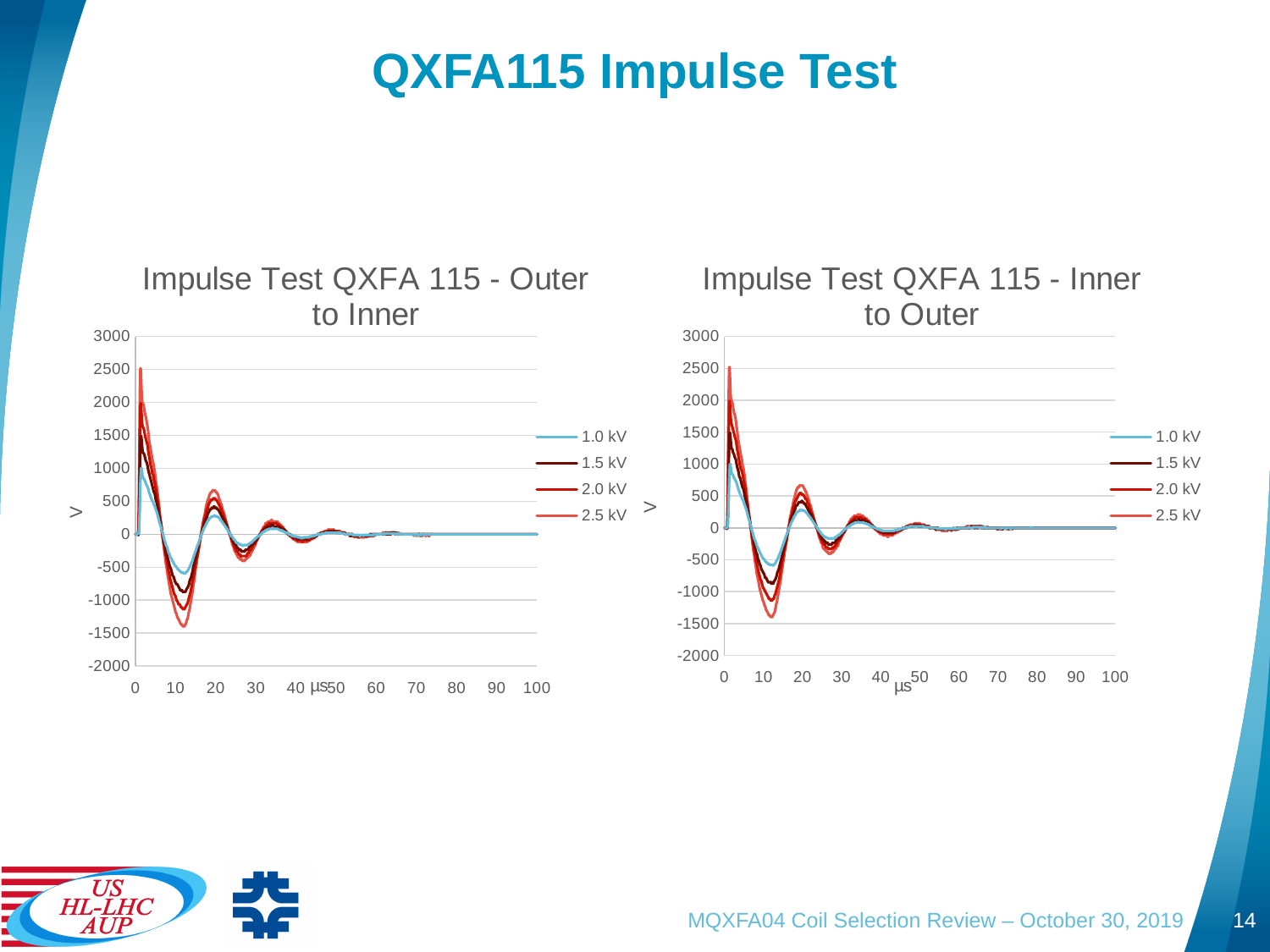
In the 'Impulse Test QXFA 115 - Outer to Inner' chart, which series has the larger first peak, 1.5 kV or 2.0 kV? 2.0 kV In the 'Impulse Test QXFA 115 - Outer to Inner' chart, is the peak value of the 2.5 kV series greater or less than 2000? greater In the 'Impulse Test QXFA 115 - Outer to Inner' chart, which series reaches the highest peak value? 2.5 kV In the 'Impulse Test QXFA 115 - Outer to Inner' chart, is the lowest value of the 2.5 kV series greater or less than -1000? less In the 'Impulse Test QXFA 115 - Inner to Outer' chart, how does the amplitude of the oscillation change as time increases along the x axis? It decreases toward 0 What is the x-axis unit label on the 'Impulse Test QXFA 115 - Inner to Outer' chart? µs How many series does the legend of the 'Impulse Test QXFA 115 - Inner to Outer' chart list? 4 What kind of chart is the 'Impulse Test QXFA 115 - Outer to Inner' chart? line chart In the 'Impulse Test QXFA 115 - Inner to Outer' chart, which series has the lowest peak value? 1.0 kV What are the legend entries of the 'Impulse Test QXFA 115 - Outer to Inner' chart? 1.0 kV, 1.5 kV, 2.0 kV, 2.5 kV In the 'Impulse Test QXFA 115 - Inner to Outer' chart, is the peak value of the 1.0 kV series greater or less than 1500? less